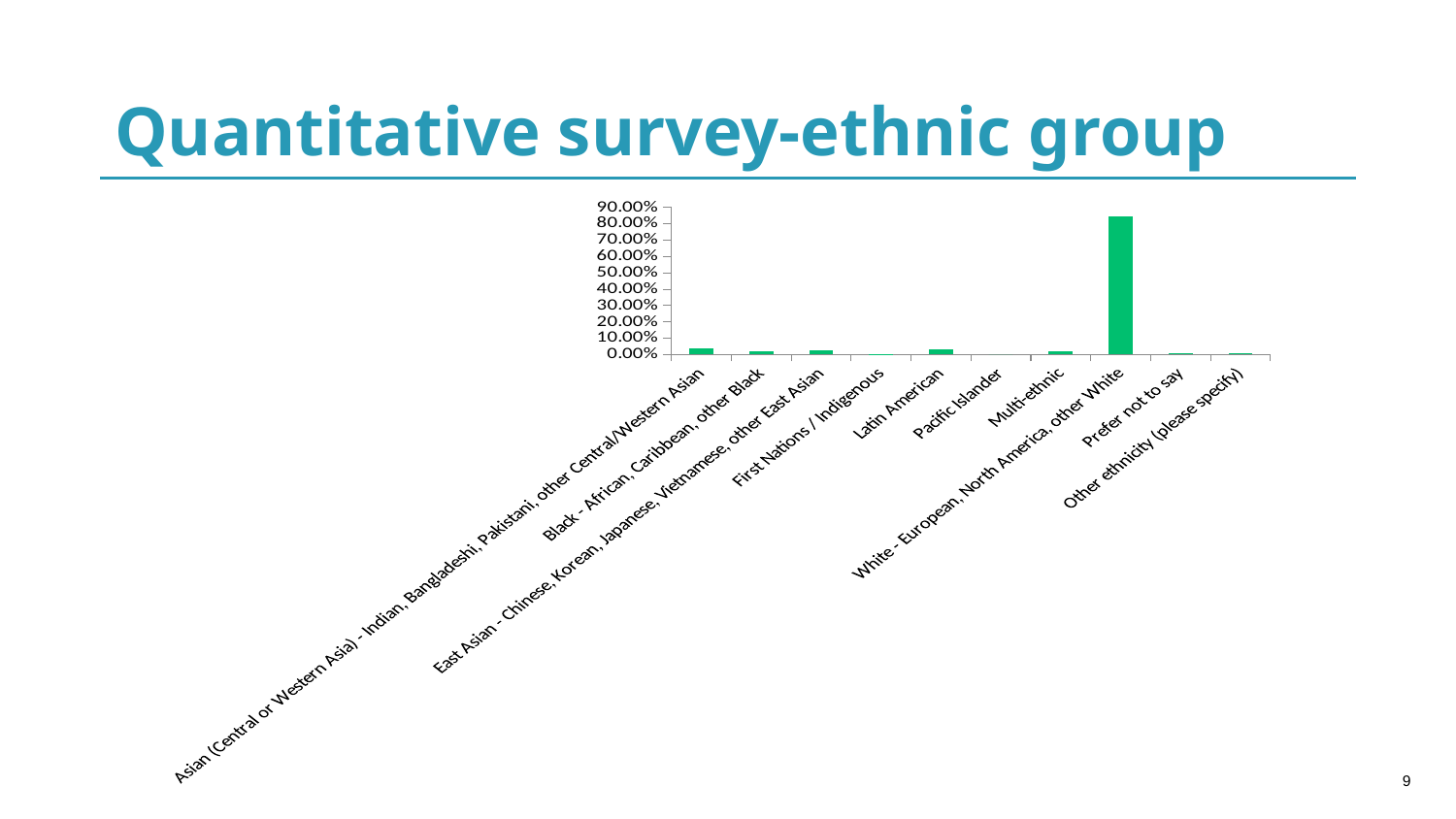
How many ethnic group categories are shown on the x axis of the chart? 10 Which is larger, the value for White - European, North America, other White or the value for Latin American? White - European, North America, other White What is the title of the slide containing the chart? Quantitative survey-ethnic group Is the value for Asian (Central or Western Asia) - Indian, Bangladeshi, Pakistani, other Central/Western Asian greater or less than 10.00%? less Is the value for Multi-ethnic greater or less than 10.00%? less Which is larger, the value for Black - African, Caribbean, other Black or the value for White - European, North America, other White? White - European, North America, other White Is the value for Latin American greater or less than 20.00%? less What is the highest value shown on the y axis of the chart? 90.00% What kind of chart is shown on the slide? Bar chart Which ethnic group category has the highest value in the chart? White - European, North America, other White